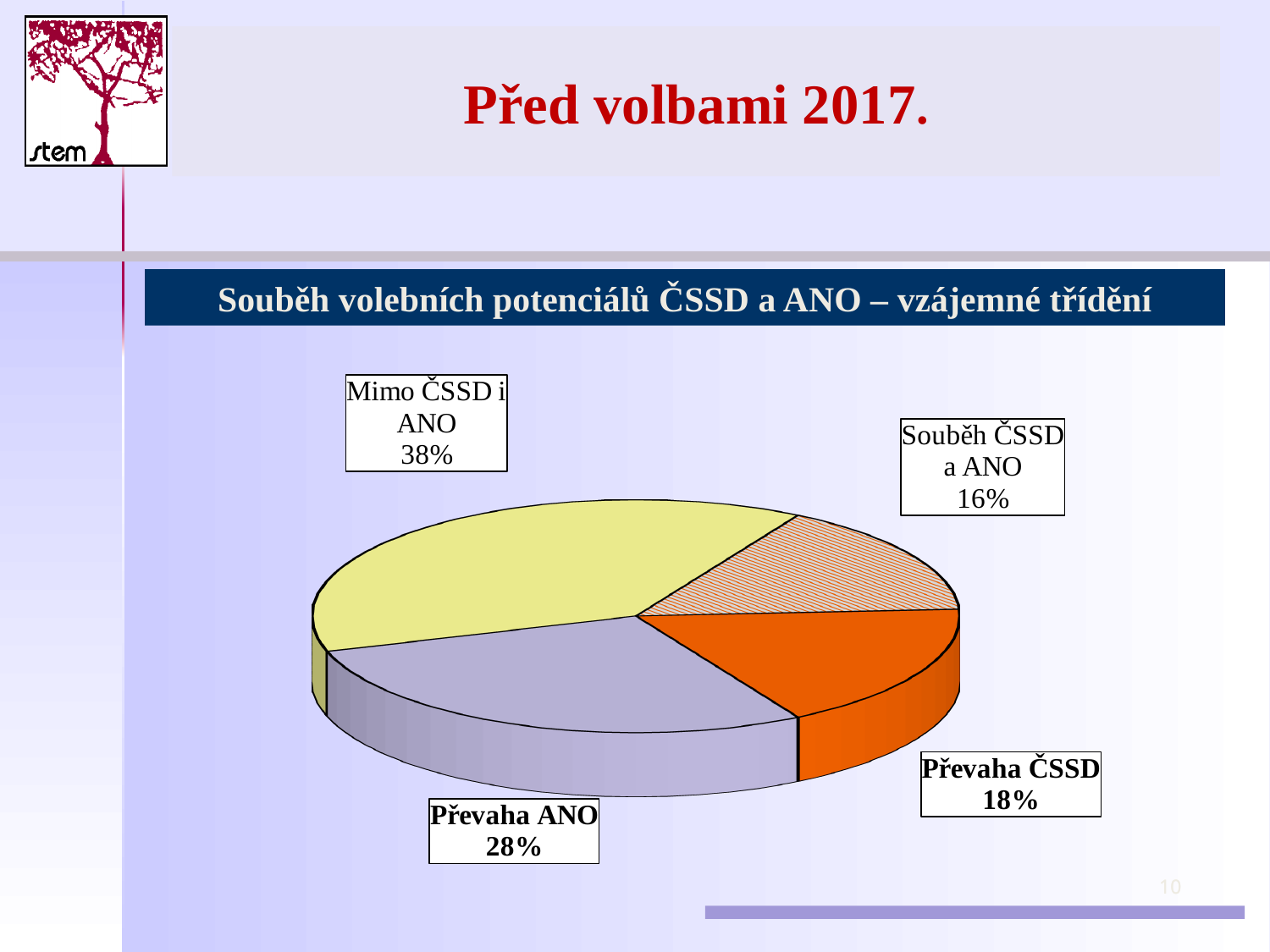
What is the share for "Převaha ANO"? 28% Which slice of the pie is the largest? Mimo ČSSD i ANO What is the combined share of "Převaha ANO" and "Převaha ČSSD"? 46% What is the share for "Převaha ČSSD"? 18% What is the share for "Mimo ČSSD i ANO"? 38% What is the title shown in the blue bar above the chart? Souběh volebních potenciálů ČSSD a ANO – vzájemné třídění How many slices does the pie chart have? 4 What is the difference in percentage points between "Mimo ČSSD i ANO" and "Převaha ANO"? 10 What is the share for "Souběh ČSSD a ANO"? 16% Which slice of the pie is the smallest? Souběh ČSSD a ANO What kind of chart is shown on the slide? pie chart Which is larger, "Převaha ANO" or "Převaha ČSSD"? Převaha ANO